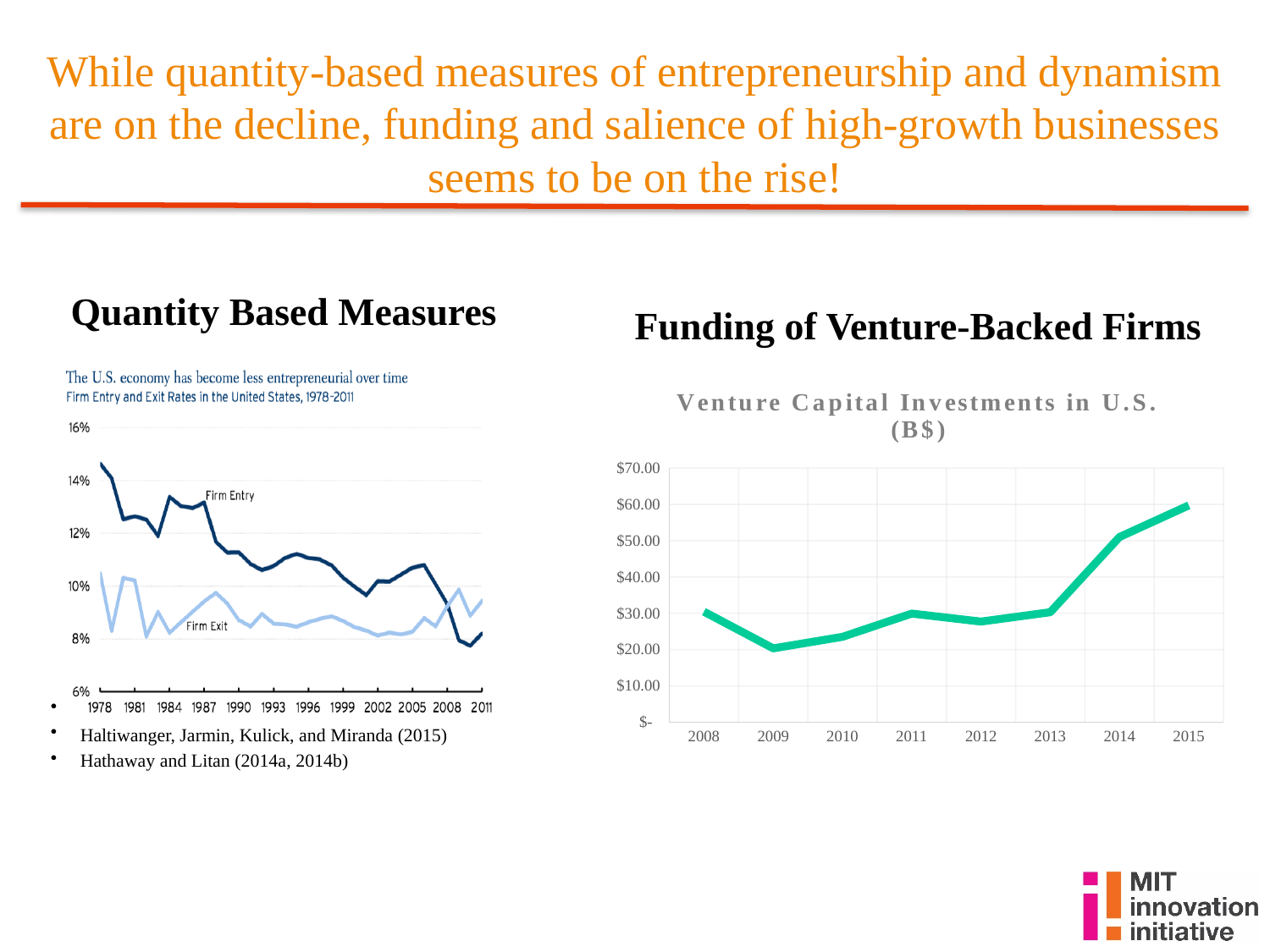
In the 'Firm Entry and Exit Rates in the United States, 1978-2011' chart on the left, does the Firm Entry line generally rise or fall from 1978 to 2011? fall What kind of chart is the 'Venture Capital Investments in U.S. (B$)' chart? line chart In the 'Venture Capital Investments in U.S. (B$)' chart, which year has the larger value, 2013 or 2014? 2014 In the 'Firm Entry and Exit Rates in the United States, 1978-2011' chart on the left, how many series are plotted? 2 In the 'Venture Capital Investments in U.S. (B$)' chart, how many years are plotted on the x axis? 8 In the 'Venture Capital Investments in U.S. (B$)' chart, which year has the lowest value? 2009 In the 'Venture Capital Investments in U.S. (B$)' chart, is the value for 2015 greater or less than $50.00? greater In the 'Venture Capital Investments in U.S. (B$)' chart, which year has the highest value? 2015 In the 'Venture Capital Investments in U.S. (B$)' chart, which year has the larger value, 2008 or 2009? 2008 In the 'Venture Capital Investments in U.S. (B$)' chart, is the value for 2014 greater or less than $40.00? greater In the 'Venture Capital Investments in U.S. (B$)' chart, is the value for 2009 greater or less than $30.00? less In the 'Venture Capital Investments in U.S. (B$)' chart, do the values rise or fall from 2013 to 2015? rise